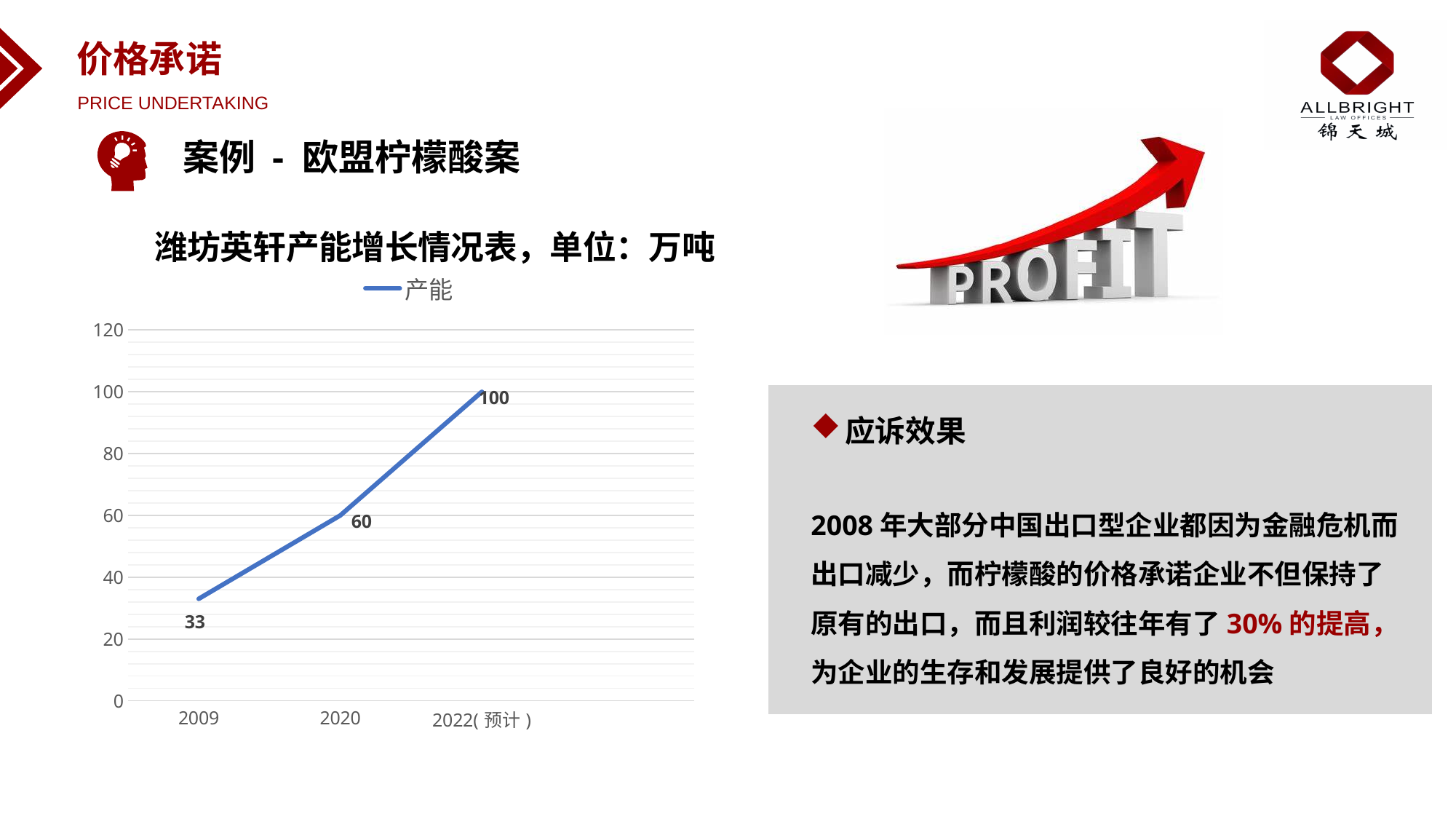
What is the difference between the values for 2022(预计) and 2009? 67 Do the values rise or fall from 2009 to 2022(预计)? rise What is the value for 2022(预计) in the line chart? 100 How many series does the legend list? 1 What is the value for 2009 in the line chart? 33 What is the value for 2020 in the line chart? 60 What kind of chart is shown on the slide? line chart What is the difference between the values for 2020 and 2009? 27 Which is larger, the value for 2020 or the value for 2009? 2020 Which year has the highest value in the line chart? 2022(预计) How many data points are plotted in the line chart? 3 Which year has the lowest value in the line chart? 2009